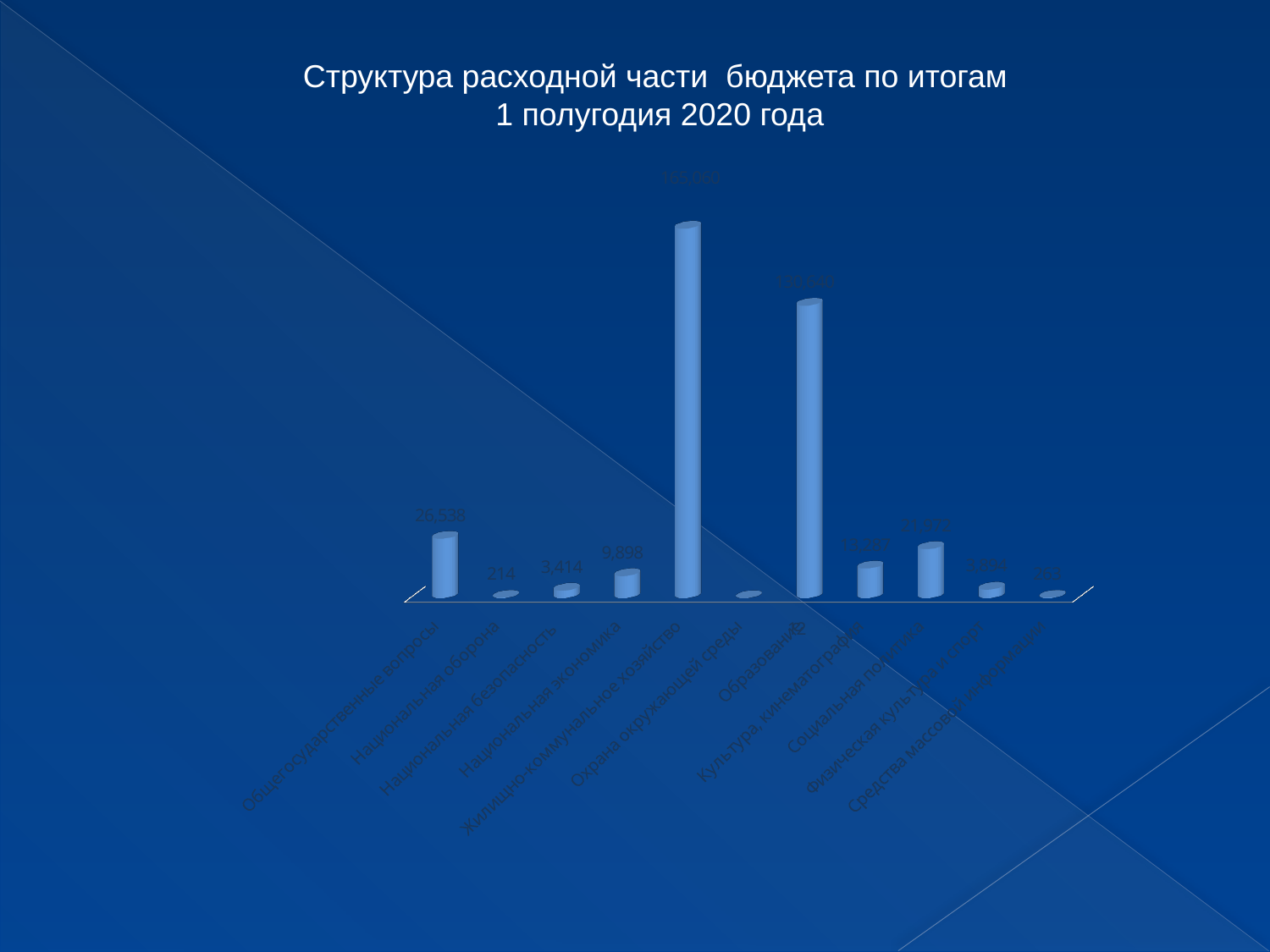
Which category has the highest value in the chart? Жилищно-коммунальное хозяйство What is the value for Национальная безопасность? 3,414 What is the value for Общегосударственные вопросы? 26,538 How many categories are plotted on the x axis of the chart? 11 Which is larger, the value for Образование or the value for Жилищно-коммунальное хозяйство? Жилищно-коммунальное хозяйство What is the value for Национальная оборона? 214 What is the title of the chart on the slide? Структура расходной части бюджета по итогам 1 полугодия 2020 года Which is larger, the value for Общегосударственные вопросы or the value for Национальная экономика? Общегосударственные вопросы What is the difference between the values for Национальная безопасность and Национальная оборона? 3,200 What is the value for Национальная экономика? 9,898 What kind of chart is shown on the slide? bar chart What is the difference between the values for Общегосударственные вопросы and Национальная экономика? 16,640